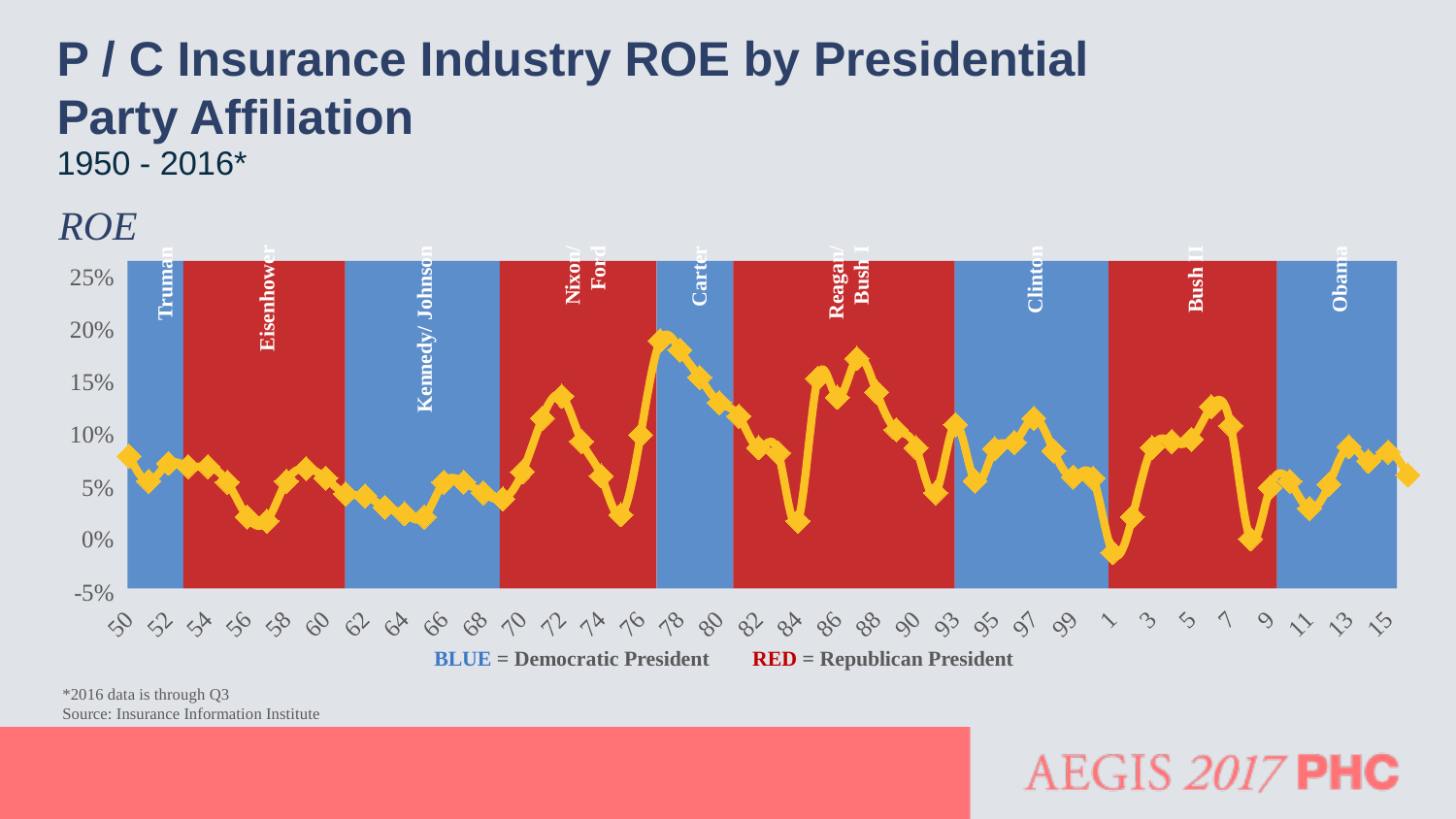
Is the ROE value for 65 greater or less than 5%? less According to the legend, what does a red background represent? Republican President How many presidential administration bands are labeled across the chart? 9 Does the ROE line rise or fall from 77 to 84? fall Is the ROE value for 87 greater or less than 15%? greater Is the ROE value for 77 greater or less than 15%? greater What is the title of the chart on the slide? P / C Insurance Industry ROE by Presidential Party Affiliation Which year has the higher ROE, 77 or 84? 77 In which year does the ROE line reach its highest point? 77 What kind of chart is shown on the slide? line chart